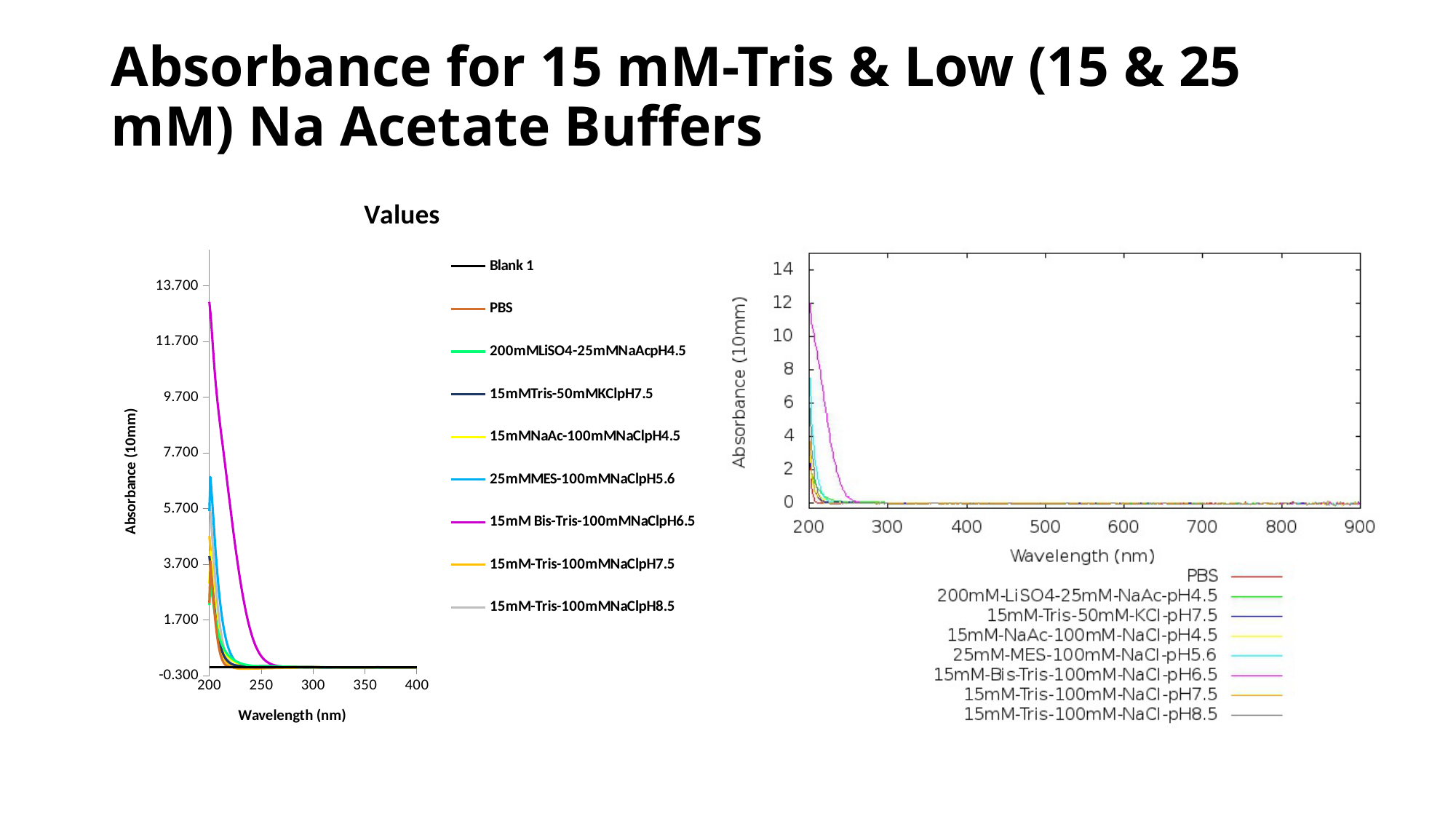
What kind of chart is the right chart? line chart In the right chart, is the peak absorbance of 15mM-Bis-Tris-100mM-NaCl-pH6.5 greater or less than 10? greater How many series does the legend of the left chart titled "Values" list? 9 How many series does the legend of the right chart list? 8 What is the highest wavelength tick shown on the x axis of the left chart titled "Values"? 400 What is the label of the x axis of the left chart titled "Values"? Wavelength (nm) In the left chart titled "Values", do the absorbance values rise or fall as wavelength increases from 200 nm? fall In the left chart titled "Values", which series reaches the highest absorbance? 15mM Bis-Tris-100mMNaClpH6.5 In the left chart titled "Values", which series has the higher peak absorbance: 15mM Bis-Tris-100mMNaClpH6.5 or 25mMMES-100mMNaClpH5.6? 15mM Bis-Tris-100mMNaClpH6.5 What kind of chart is the left chart titled "Values"? line chart In the right chart, which series reaches the highest absorbance? 15mM-Bis-Tris-100mM-NaCl-pH6.5 In the left chart titled "Values", is the peak absorbance of 15mM Bis-Tris-100mMNaClpH6.5 greater or less than 11.700? greater